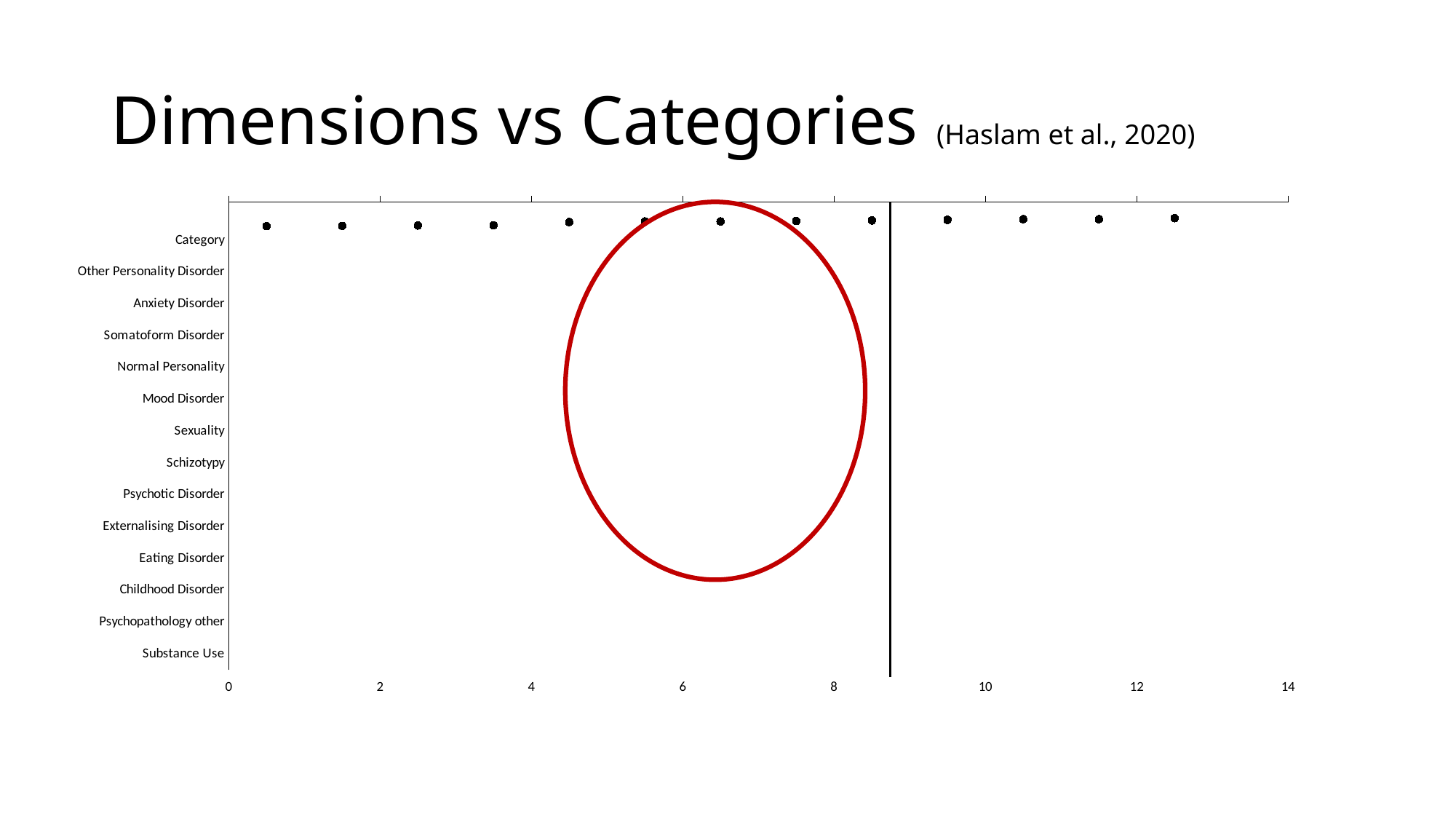
How many data points lie to the right of the vertical black line on the chart? 4 What kind of chart is shown on the slide? scatter chart How many data points are plotted on the chart? 13 Which category label appears at the bottom of the vertical axis? Substance Use What is the maximum value shown on the horizontal axis of the chart? 14 Is the leftmost data point on the chart greater or less than 2? less Is the rightmost data point on the chart greater or less than 12? greater How many category labels are listed on the vertical axis of the chart? 14 What is the title of the slide containing the chart? Dimensions vs Categories